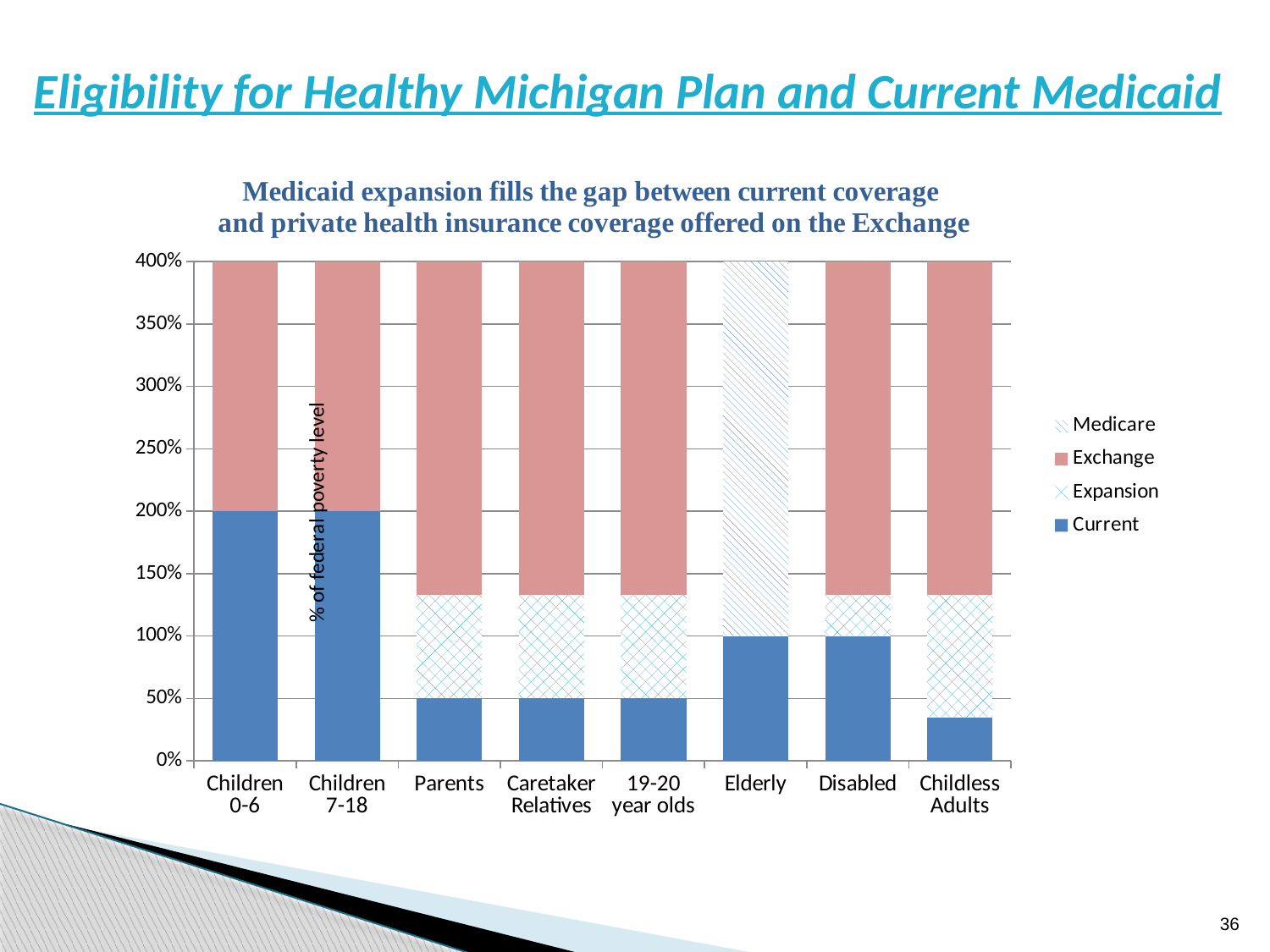
What kind of chart is shown on the slide? stacked bar chart Which category is the only one with a Medicare segment? Elderly How many categories are shown on the x axis? 8 Which is larger, the Current value for Children 7-18 or the Current value for Disabled? Children 7-18 What is the label on the y axis? % of federal poverty level Is the Current value for Childless Adults greater or less than 50%? less Which category has the lowest Current value? Childless Adults What is the Current value for Elderly? 100% How many series does the legend list? 4 Is the Current value for Parents greater or less than 100%? less Is the top of the Expansion segment for Parents greater or less than 150%? less What is the Current value for Children 0-6? 200%